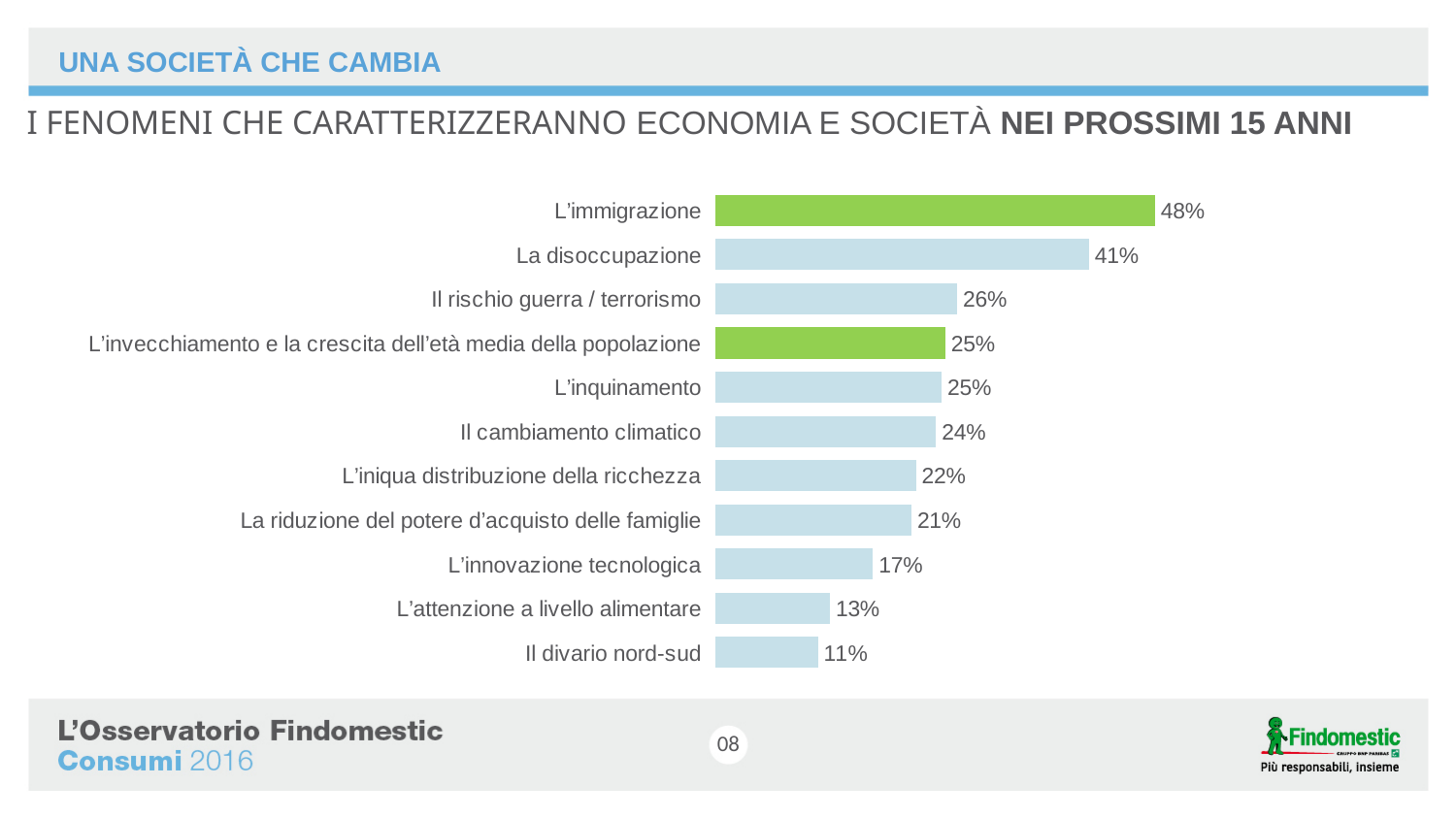
Which category has the lowest value? Il divario nord-sud What is the value for La disoccupazione? 41% What is the difference between the values for Il rischio guerra / terrorismo and L'innovazione tecnologica? 9% What kind of chart is shown on the slide? Bar chart Which two categories are highlighted with green bars? L'immigrazione and L'invecchiamento e la crescita dell'età media della popolazione Which is larger, the value for L'iniqua distribuzione della ricchezza or the value for L'attenzione a livello alimentare? L'iniqua distribuzione della ricchezza How many categories are shown in the chart? 11 Which category has the highest value? L'immigrazione What is the value for Il cambiamento climatico? 24% What is the difference between the values for L'immigrazione and La disoccupazione? 7% What is the value for L'immigrazione? 48% What is the value for Il divario nord-sud? 11%